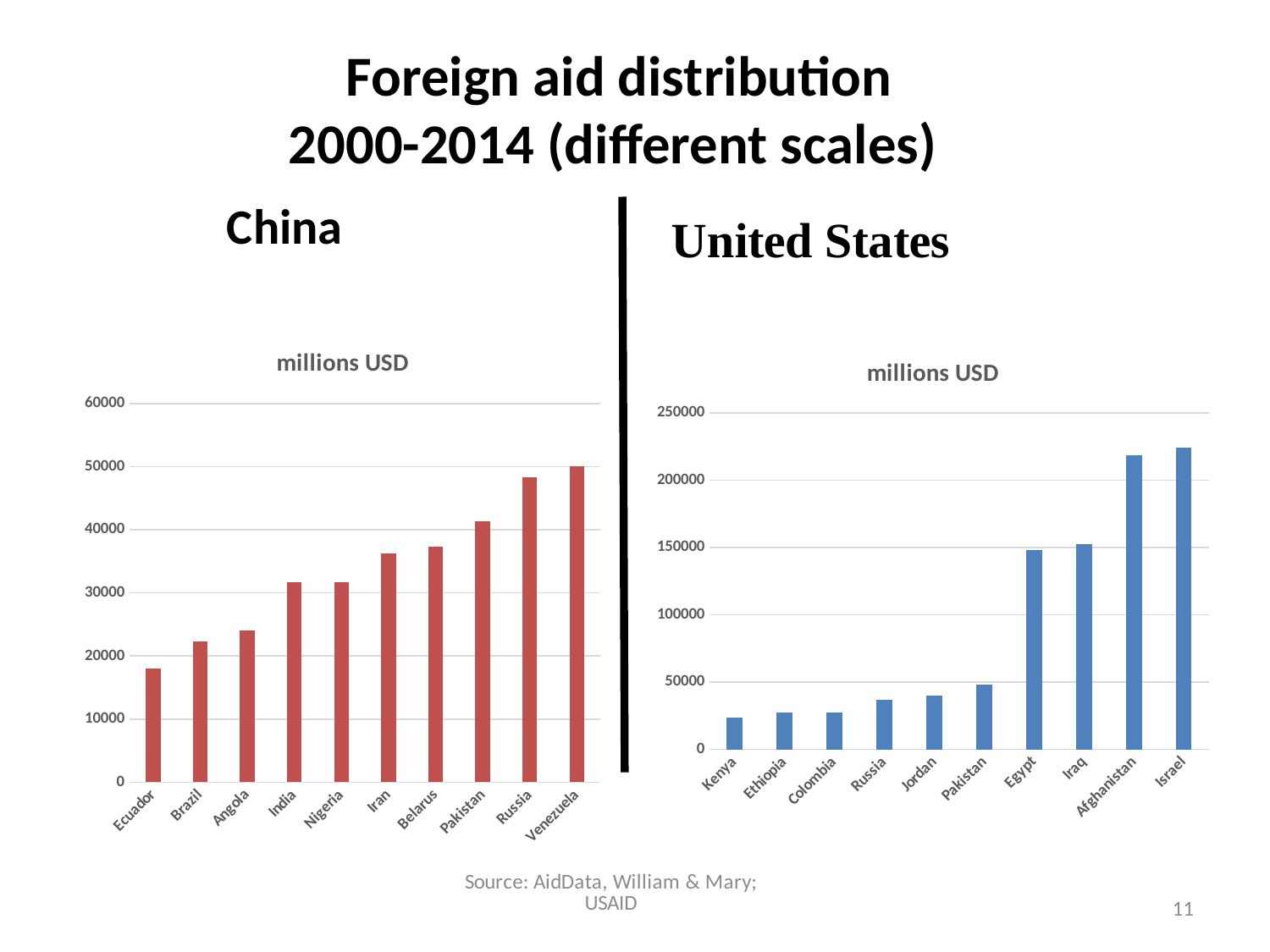
On the China chart, is the value for Pakistan greater or less than 40000? greater On the United States chart, is the value for Jordan greater or less than 50000? less On the United States chart, which is larger, the value for Pakistan or the value for Iraq? Iraq On the United States chart, do the values generally rise or fall from left to right? rise What kind of chart is the United States chart? bar chart On the China chart, which is larger, the value for Brazil or the value for Iran? Iran On the China chart, which country has the highest value? Venezuela On the United States chart, is the value for Egypt greater or less than 100000? greater What unit is given in the title of the China chart? millions USD How many countries are shown on the China chart? 10 On the China chart, which country has the lowest value? Ecuador